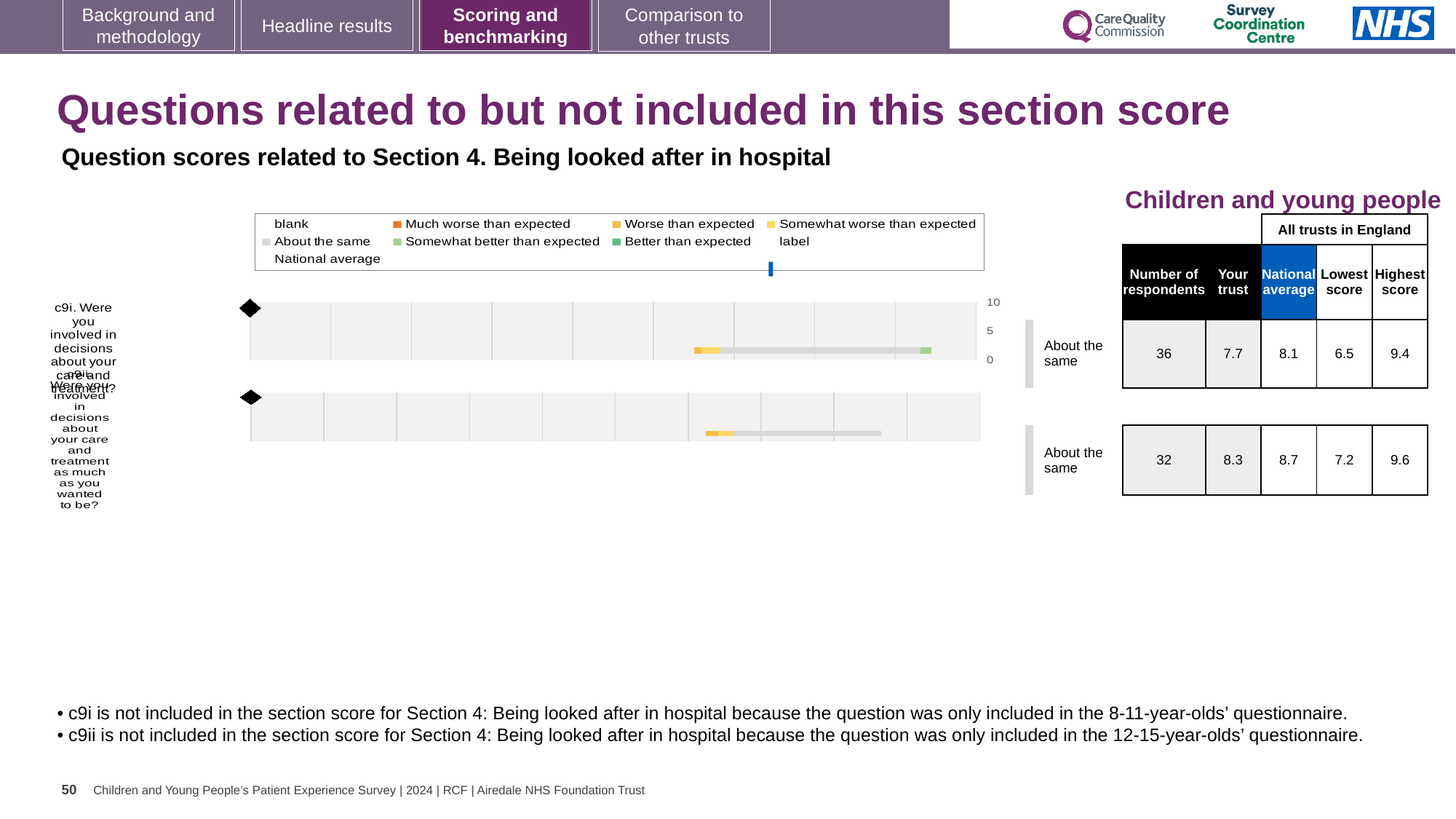
Which question has the higher 'Your trust' score, c9i or c9ii? c9ii What benchmark category is shown next to the bar for c9ii? About the same How many respondents answered question c9i? 36 How many more respondents answered c9i than c9ii? 4 What kind of chart is used to show the question scores for c9i and c9ii? bar chart What is the lowest score across all trusts in England for c9i? 6.5 What colour does the legend use for 'Better than expected'? green What is the highest score across all trusts in England for c9ii? 9.6 What is the difference between the national average and the 'Your trust' score for c9i? 0.4 How many questions are plotted in the chart? 2 According to the table beside the chart, what is the 'Your trust' score for c9i? 7.7 According to the table beside the chart, what is the national average for c9ii? 8.7